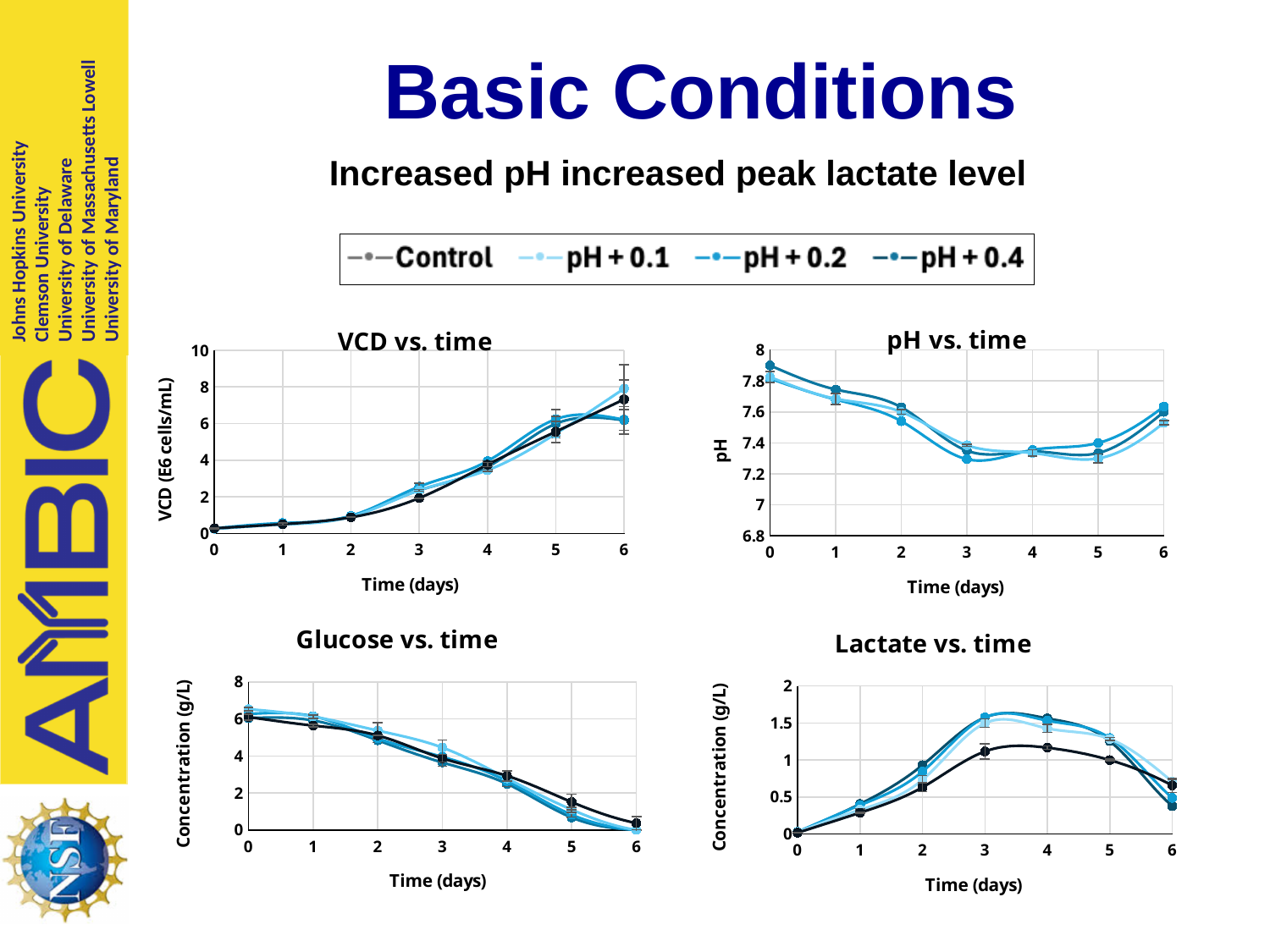
What is the y-axis label of the 'Glucose vs. time' chart? Concentration (g/L) How many series does the shared legend list? 4 In the 'pH vs. time' chart, is the value at day 0 greater or less than 7.6? greater In the 'Glucose vs. time' chart, is the value at day 6 greater or less than 2? less In the 'Glucose vs. time' chart, do the values rise or fall from day 0 to day 6? fall In the 'VCD vs. time' chart, do the values rise or fall from day 0 to day 6? rise In the 'pH vs. time' chart, do the values rise or fall between day 0 and day 3? fall In the 'VCD vs. time' chart, how many time points are plotted along the x axis? 7 In the 'Lactate vs. time' chart, is the value at day 0 greater or less than 0.5? less What kind of chart is the 'VCD vs. time' chart? line chart